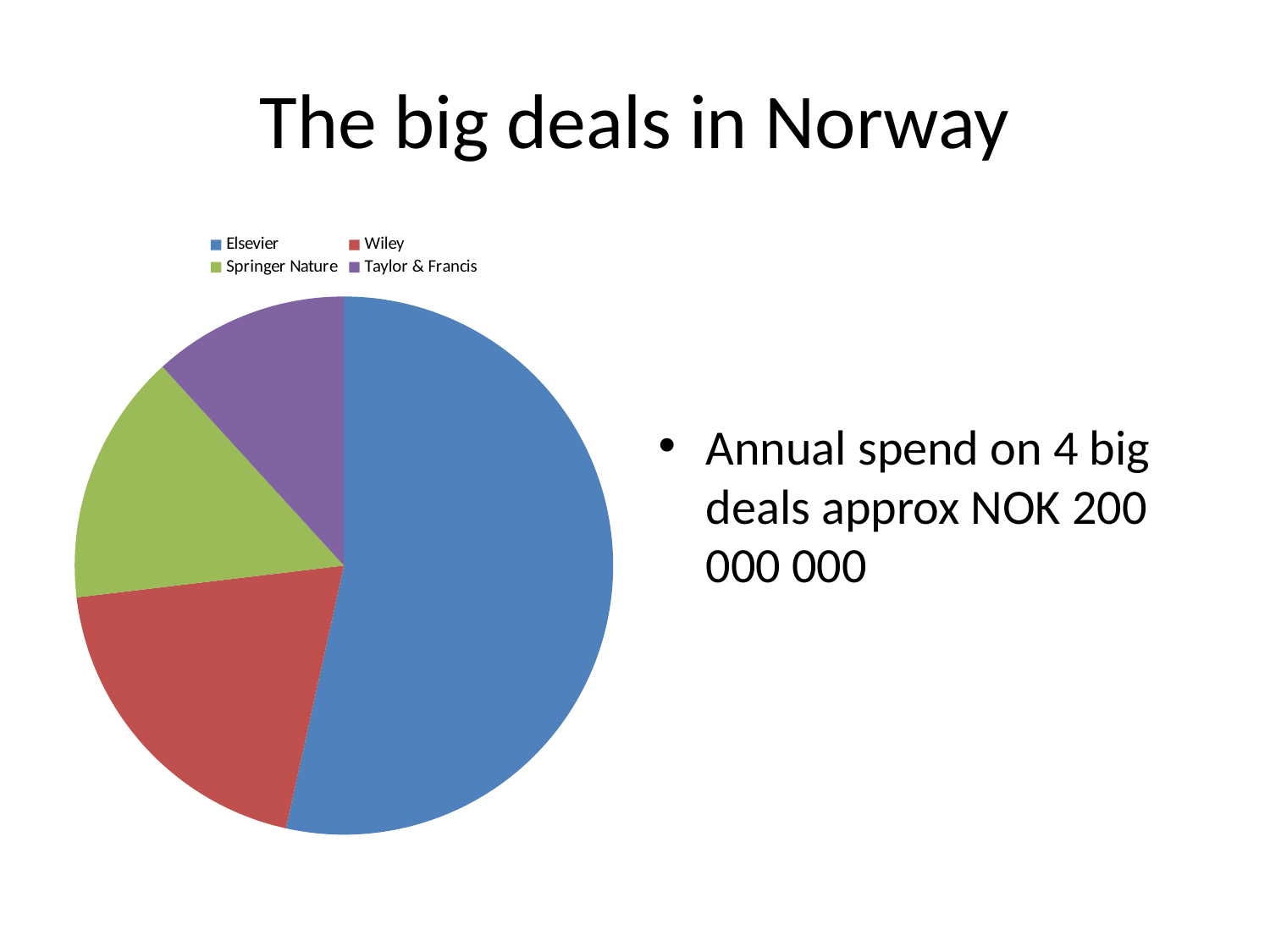
What is the title of the slide containing the pie chart? The big deals in Norway Which slice is larger, Springer Nature or Taylor & Francis? Springer Nature How many slices does the pie chart have? 4 What kind of chart is shown on the slide? pie chart How many entries does the legend of the pie chart list? 4 Which publisher has the smallest slice of the pie chart? Taylor & Francis Which slice is larger, Wiley or Springer Nature? Wiley Which publisher has the largest slice of the pie chart? Elsevier Which slice is larger, Elsevier or Wiley? Elsevier Which publisher is shown in green in the pie chart? Springer Nature Is Elsevier's share of the pie greater or less than 50%? greater